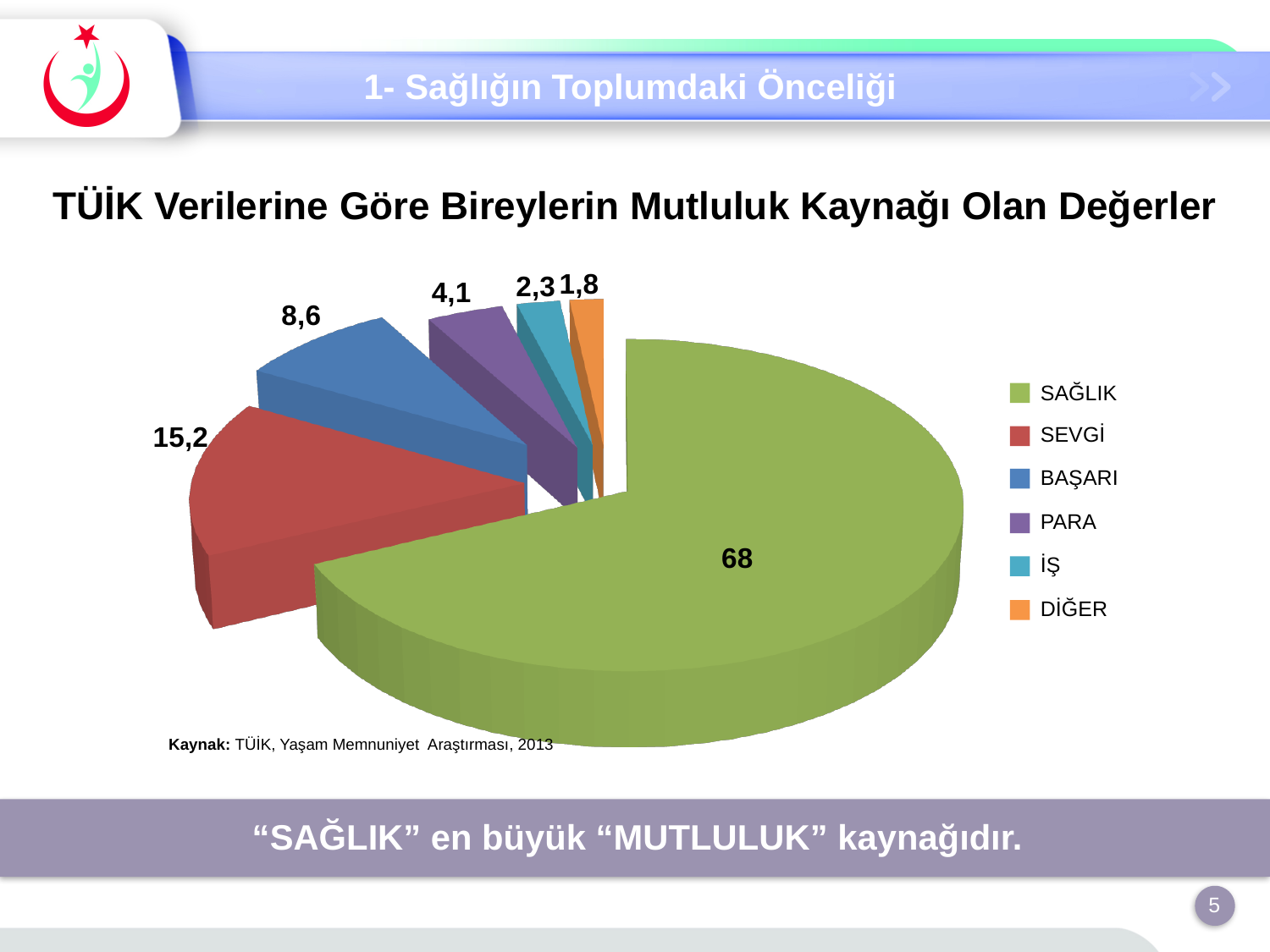
What is the difference between the values for SAĞLIK and SEVGİ? 52,8 What is the value for PARA in the pie chart? 4,1 Which category has the smallest slice in the pie chart? DİĞER What is the value for DİĞER in the pie chart? 1,8 What type of chart is shown on the slide? Pie chart What is the value for BAŞARI in the pie chart? 8,6 Which category has the largest slice in the pie chart? SAĞLIK What is the title of the chart on the slide? TÜİK Verilerine Göre Bireylerin Mutluluk Kaynağı Olan Değerler What is the value for SAĞLIK in the pie chart? 68 Which is larger, the value for BAŞARI or the value for PARA? BAŞARI What is the value for SEVGİ in the pie chart? 15,2 How many categories does the legend of the pie chart list? 6